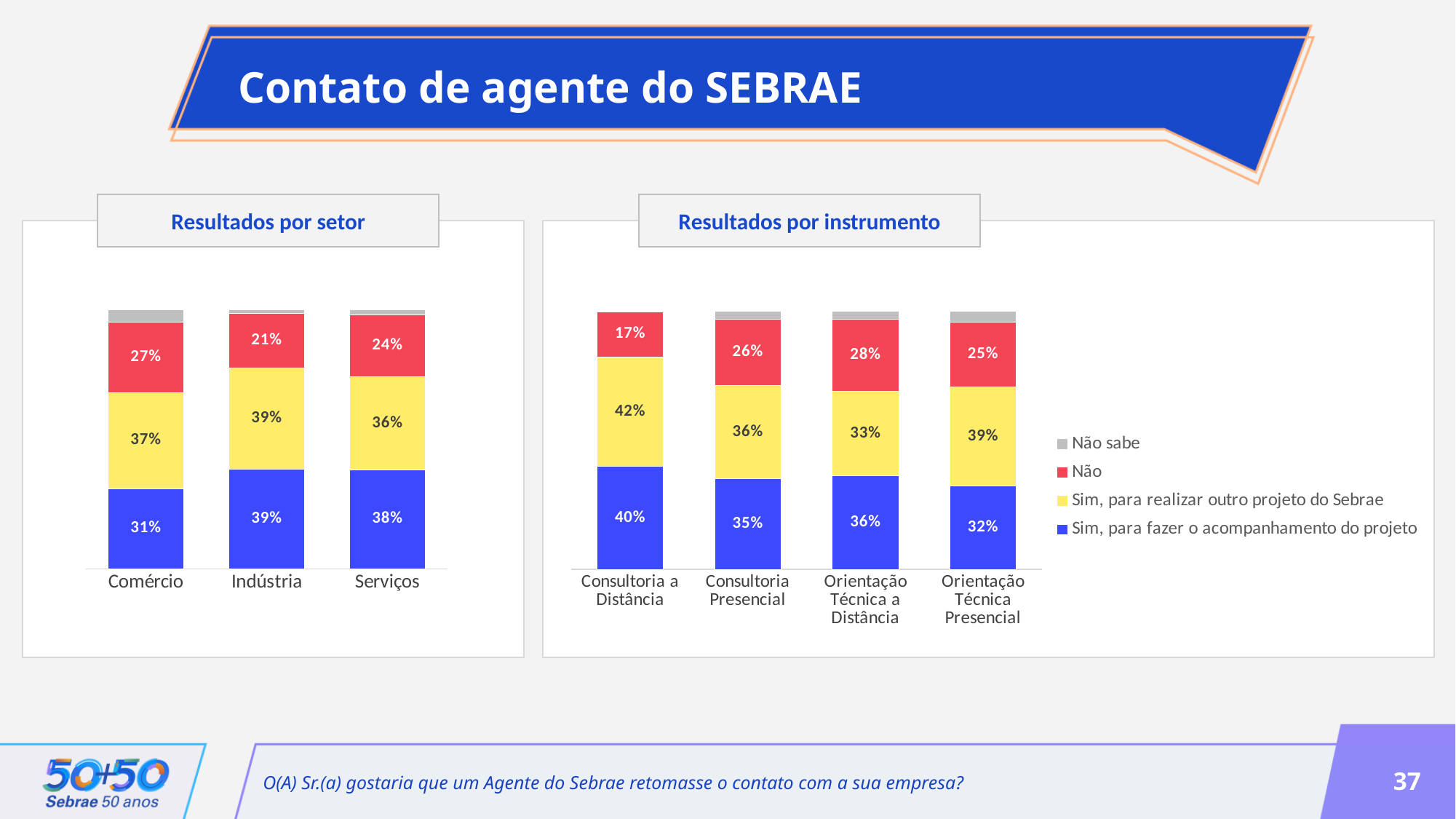
In the 'Resultados por setor' chart, what is the value of 'Sim, para fazer o acompanhamento do projeto' for Comércio? 31% How many series does the legend list? 4 In the 'Resultados por instrumento' chart, how many instruments are shown on the x axis? 4 In the 'Resultados por setor' chart, which sector has the highest 'Não' value? Comércio In the 'Resultados por instrumento' chart, what is the 'Não' value for Consultoria a Distância? 17% In the 'Resultados por setor' chart, what is the 'Não' value for Indústria? 21% In the 'Resultados por setor' chart, how many sectors are shown? 3 In the 'Resultados por setor' chart, what is the difference between the 'Sim, para realizar outro projeto do Sebrae' values for Indústria and Serviços? 3% In the 'Resultados por instrumento' chart, what is the 'Sim, para realizar outro projeto do Sebrae' value for Orientação Técnica Presencial? 39% In the 'Resultados por instrumento' chart, which instrument has the lowest 'Sim, para fazer o acompanhamento do projeto' value? Orientação Técnica Presencial What type of chart is 'Resultados por setor'? Stacked bar chart In the 'Resultados por instrumento' chart, which is larger: the 'Não' value for Consultoria Presencial or for Orientação Técnica a Distância? Orientação Técnica a Distância